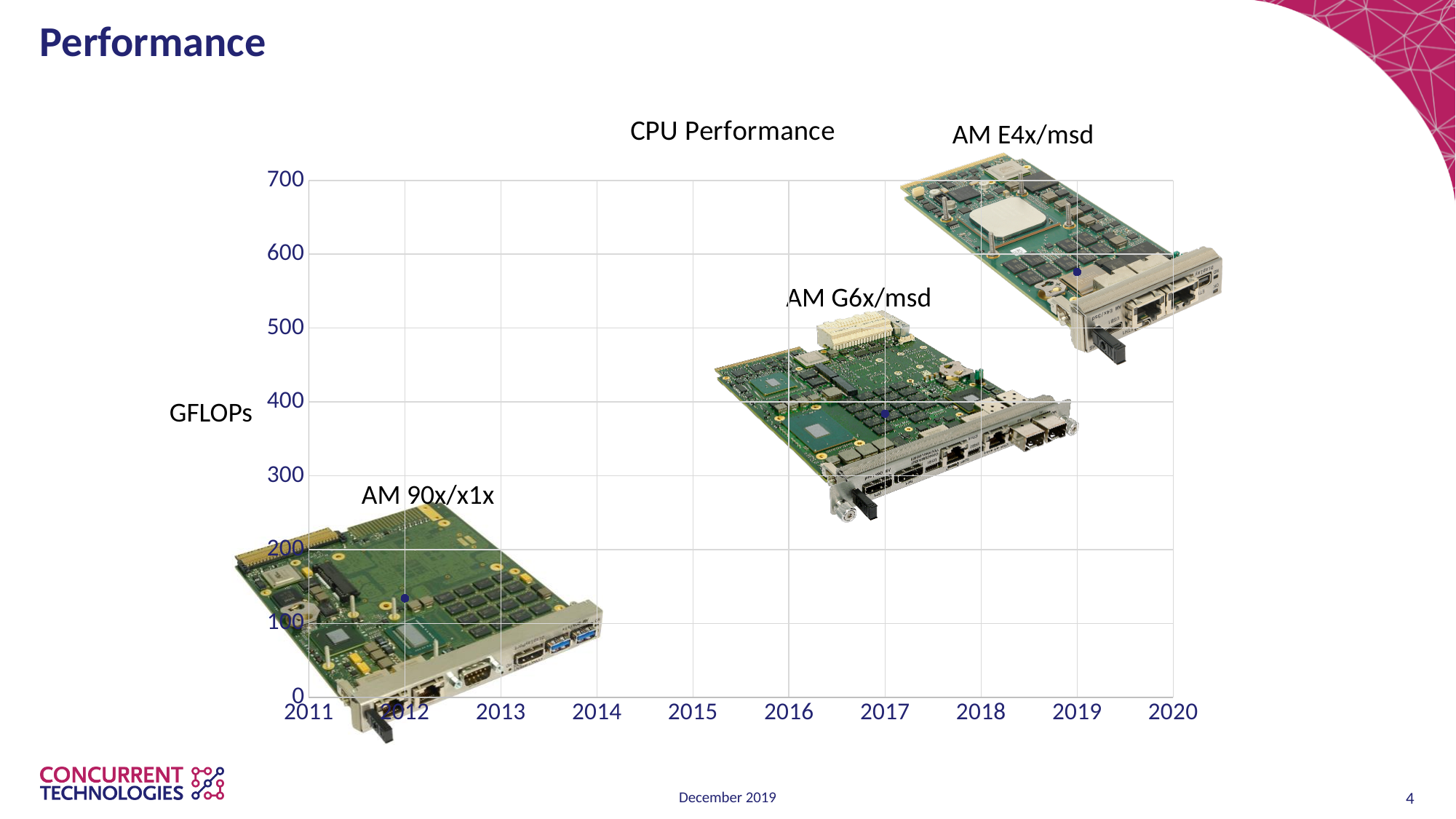
Is the GFLOPs value for AM G6x/msd greater or less than 300? greater What is the label on the vertical axis of the chart? GFLOPs Which has the larger GFLOPs value, AM G6x/msd or AM 90x/x1x? AM G6x/msd What kind of chart is shown on the slide? scatter chart In which year is the AM E4x/msd data point plotted? 2019 How many data points are plotted on the chart? 3 Which product has the lowest GFLOPs value on the chart? AM 90x/x1x Do the plotted GFLOPs values rise or fall as the years increase along the x axis? rise Is the GFLOPs value for AM 90x/x1x greater or less than 200? less Which product has the highest GFLOPs value on the chart? AM E4x/msd What is the title of the chart? CPU Performance Is the GFLOPs value for AM E4x/msd greater or less than 500? greater